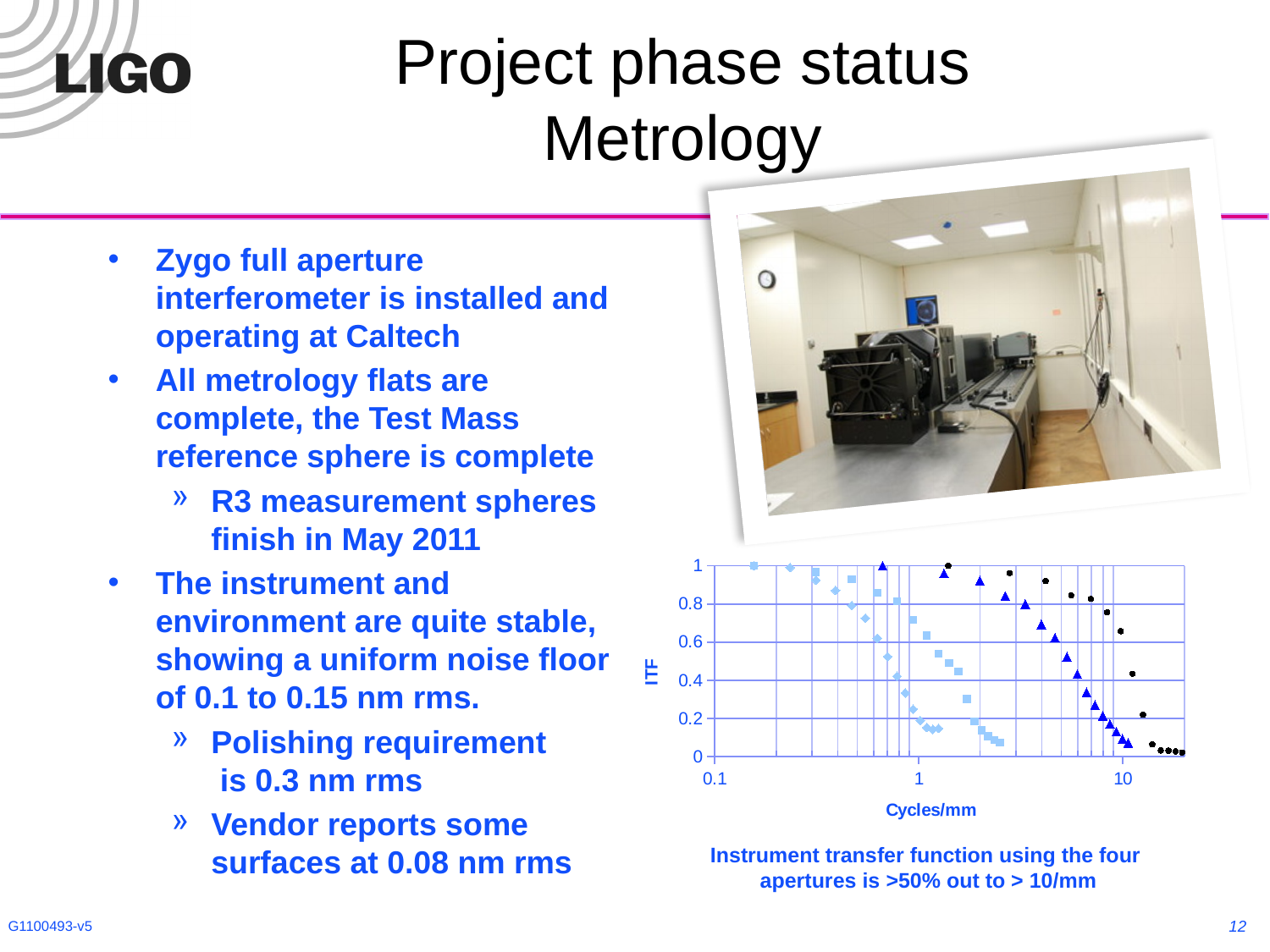
What is the label of the y axis of the chart? ITF What is the highest tick value shown on the x axis of the chart? 10 What kind of chart is shown on the slide? scatter chart Do the plotted ITF values rise or fall as Cycles/mm increases along the x axis? fall What is the lowest tick value shown on the x axis of the chart? 0.1 What is the label of the x axis of the chart? Cycles/mm What is the highest tick value shown on the y axis of the chart? 1 How many tick labels are shown on the x axis of the chart? 3